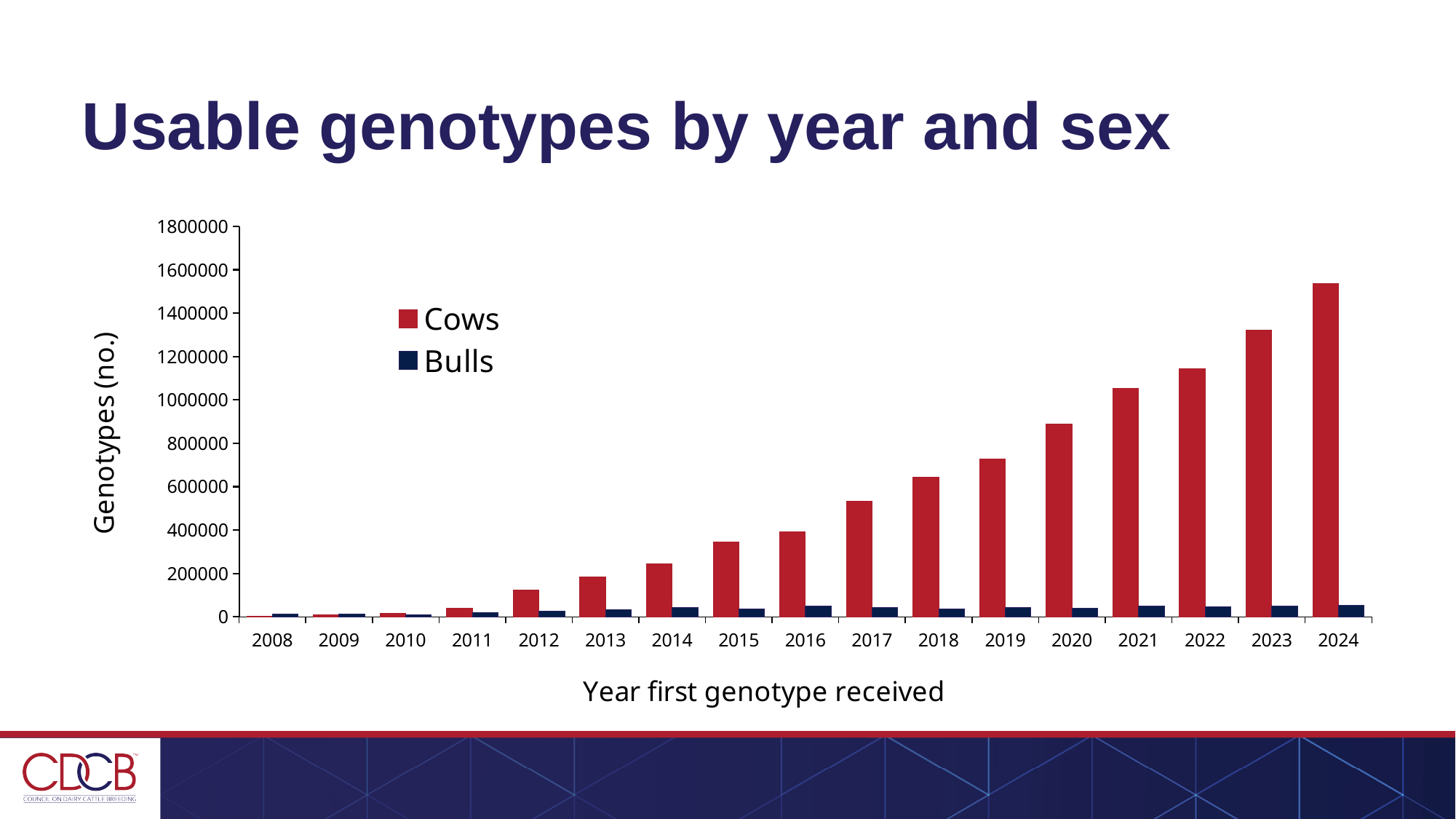
Is the value for Cows in 2020 greater or less than 1000000? less Do the values for Cows rise or fall from 2008 to 2024? rise Is the value for Cows in 2012 greater or less than 200000? less Is the value for Cows in 2024 greater or less than 1400000? greater Which year has the lowest value for Cows? 2008 What kind of chart is shown on the slide? bar chart How many years are shown on the x axis? 17 How many series does the legend list? 2 Which year has the highest value for Cows? 2024 In 2024, which is larger, the value for Cows or the value for Bulls? Cows What is the label of the x axis? Year first genotype received